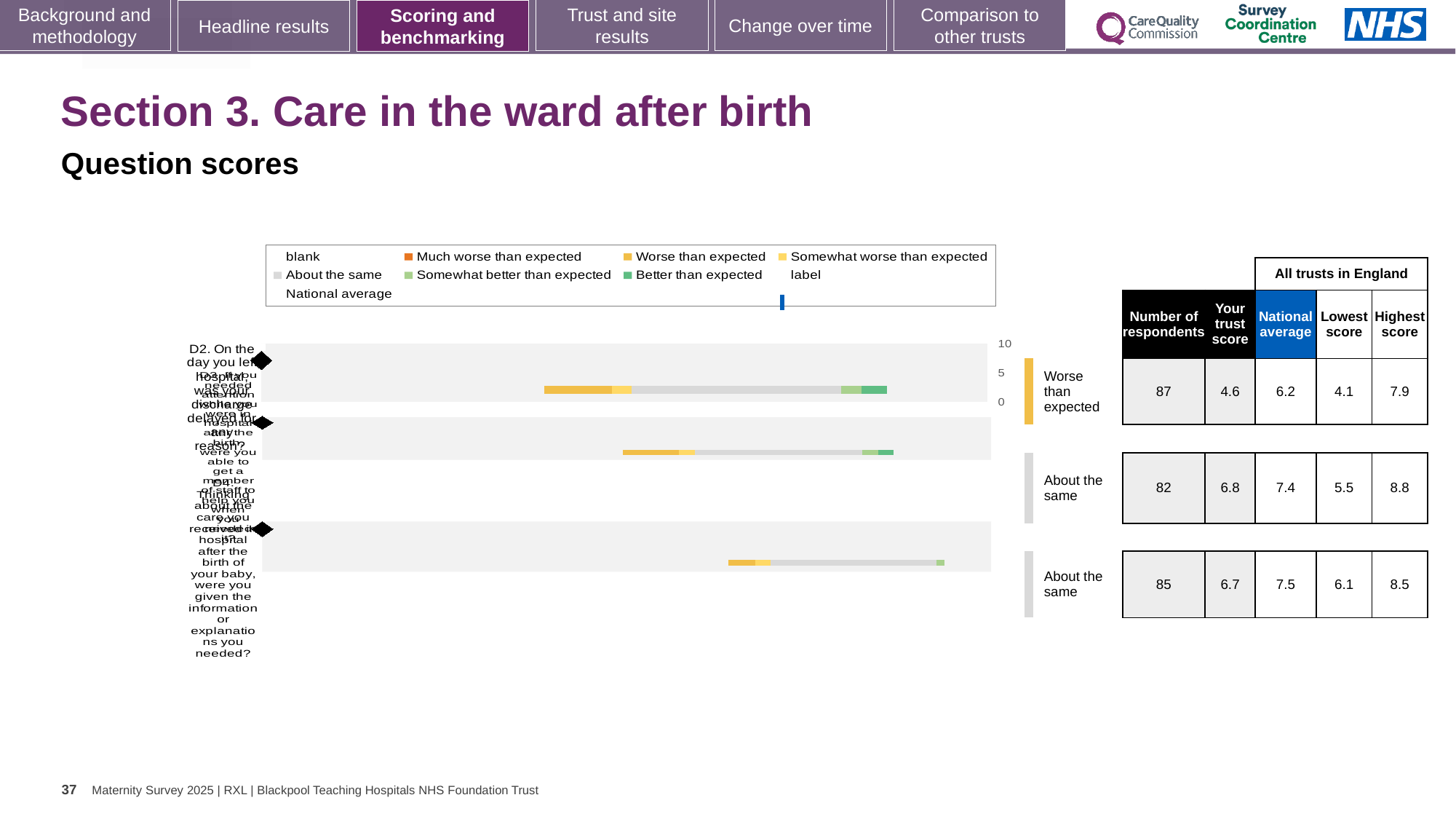
In the table beside the chart, what is the number of respondents for the top question row? 87 For the second question row, what is the difference between the national average and the trust score? 0.6 Which question row has the highest trust score? the second row (6.8) What kind of chart is shown on the slide? bar chart What is the national average for the top question row? 6.2 What is the trust score for the top question row? 4.6 What rating label is shown next to the top question row? Worse than expected What is the lowest score for the third (bottom) question row? 6.1 Which question row has the lowest number of respondents? the second row (82) What is the highest score for the second question row? 8.8 How many question rows (bars) are plotted in the chart? 3 For the top question row, which is larger: the trust score or the national average? national average